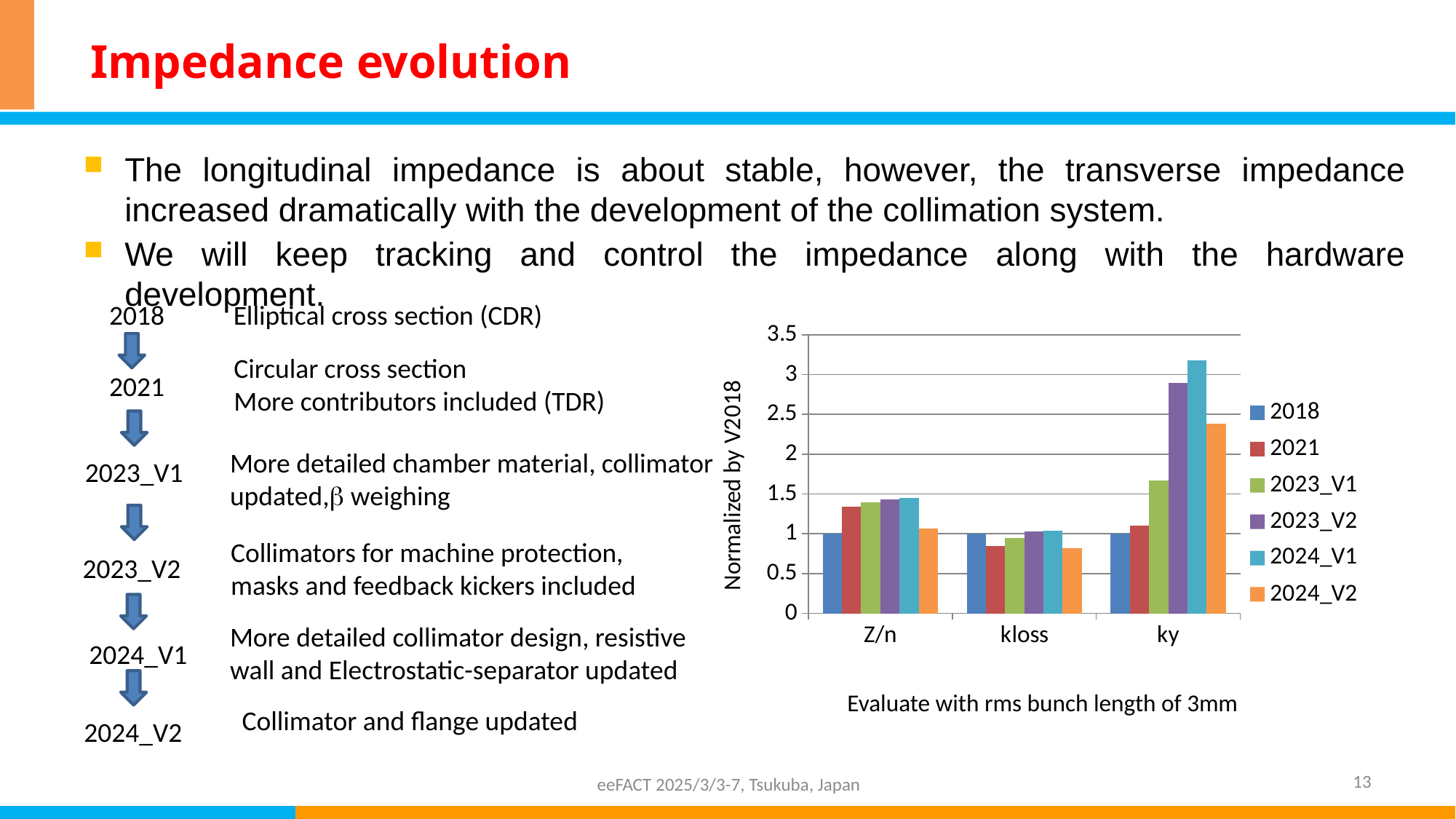
Is the value for 2023_V2 in the ky category greater or less than 2.5? greater How many categories are shown on the x axis of the chart? 3 What is the label of the vertical axis of the chart? Normalized by V2018 How many series does the chart legend list? 6 In the ky category, which is larger: the 2024_V1 bar or the 2024_V2 bar? 2024_V1 Which series has the highest bar in the ky category? 2024_V1 What rms bunch length does the caption below the chart say was used for the evaluation? 3mm What kind of chart is shown on the slide? bar chart What is the value of the 2018 bar for Z/n? 1 Is the value for 2024_V1 in the ky category greater or less than 3? greater Is the value for 2023_V1 in the ky category greater or less than 1.5? greater